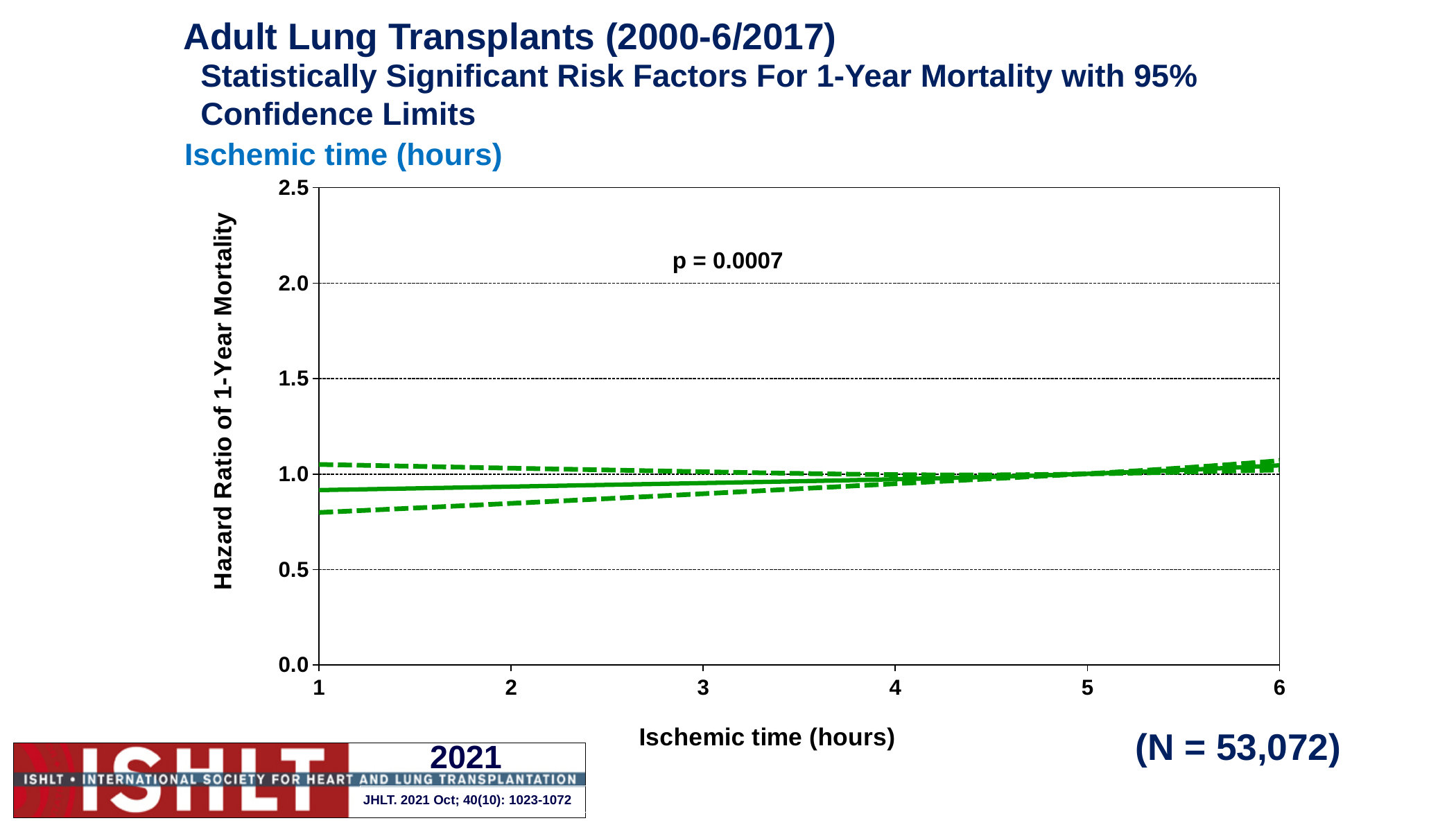
How many tick labels are shown on the x axis (ischemic time)? 6 What p-value is printed on the chart? p = 0.0007 What kind of chart is shown on the slide? line chart Is the lower 95% confidence limit at an ischemic time of 1 hour greater or less than 1.0? less What sample size (N) is shown on the slide? N = 53,072 Is the upper 95% confidence limit at an ischemic time of 6 hours greater or less than 1.5? less Is the hazard ratio of 1-year mortality at an ischemic time of 1 hour greater or less than 1.5? less Does the hazard ratio of 1-year mortality rise or fall as ischemic time increases from 1 to 6 hours? rise